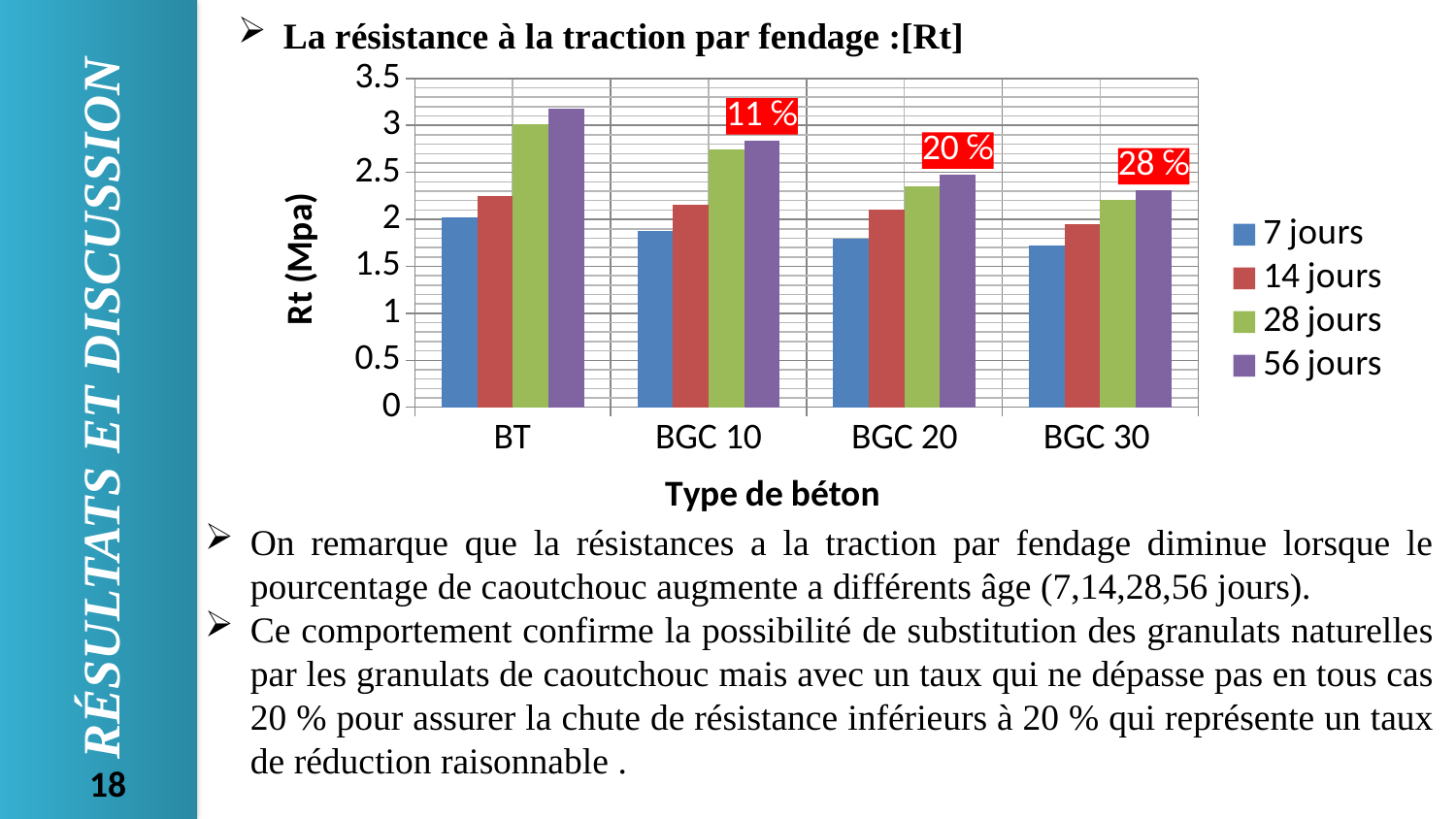
Is the 28 jours value for BGC 20 greater or less than 2? greater What kind of chart is shown on the slide? bar chart Do the 56 jours values rise or fall from BT to BGC 30 along the x axis? fall Is the 56 jours value for BGC 10 greater or less than 3? less Which concrete type has the lowest 7 jours value? BGC 30 Is the 56 jours value for BT greater or less than 3? greater Which concrete type has the highest 56 jours value? BT How many series does the legend list? 4 How many concrete types (categories) are shown on the x axis? 4 What is the title of the y axis? Rt (Mpa) Which is larger, the 28 jours value for BT or the 28 jours value for BGC 10? BT